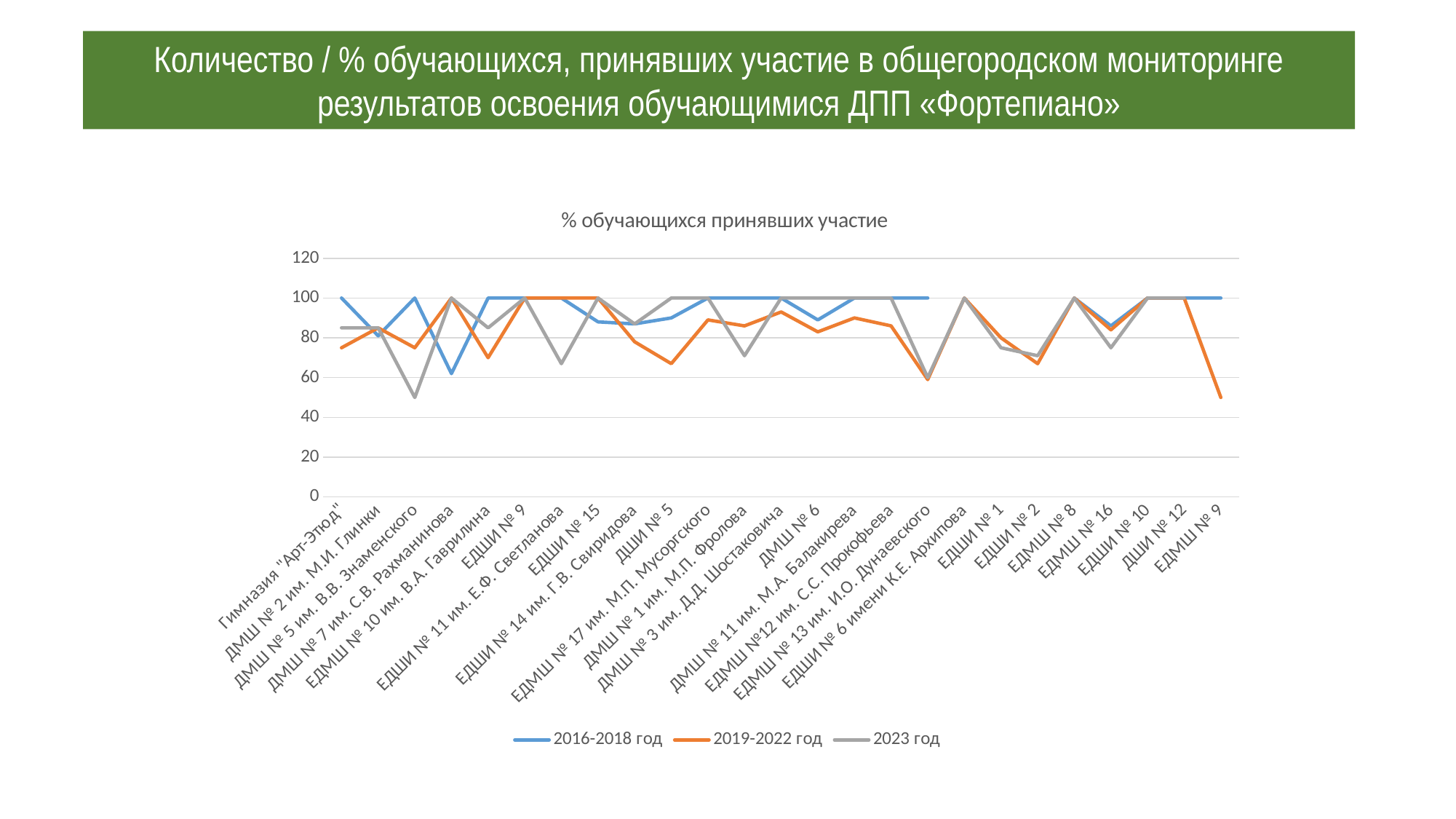
What is the value for ЕДШИ № 15 in the 2019-2022 год series? 100 Which series is drawn in grey? 2023 год For ДМШ № 7 им. С.В. Рахманинова, which series has the larger value: 2016-2018 год or 2019-2022 год? 2019-2022 год What is the value for ЕДМШ № 8 in the 2023 год series? 100 What is the title of the chart? % обучающихся принявших участие What is the value for ЕДШИ № 9 in the 2016-2018 год series? 100 Which school has the lowest value in the 2023 год series? ДМШ № 5 им. В.В. Знаменского Is the value for ЕДМШ № 9 in the 2019-2022 год series greater or less than 60? less How many series does the legend list? 3 How many schools (categories) are plotted along the x axis? 25 Is the value for ДМШ № 7 им. С.В. Рахманинова in the 2016-2018 год series greater or less than 80? less What kind of chart is shown on the slide? line chart